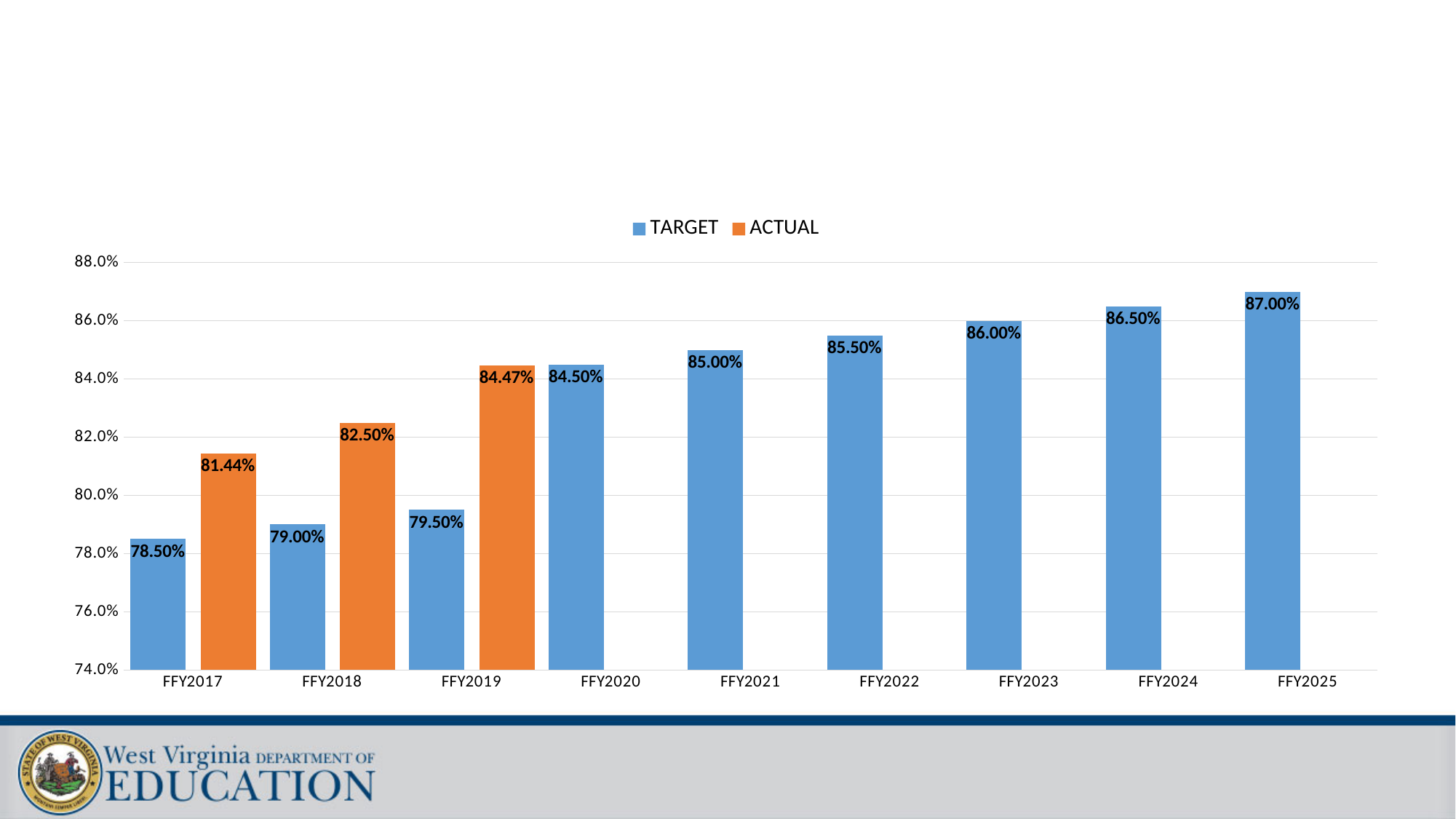
What is the ACTUAL value for FFY2018? 82.50% Do the TARGET values rise or fall from FFY2017 to FFY2025? Rise What is the difference between the ACTUAL and TARGET values for FFY2017? 2.94% What kind of chart is shown on the slide? Bar chart How many series does the legend list? 2 Which year has the lowest TARGET value? FFY2017 Which year has the highest TARGET value? FFY2025 What is the ACTUAL value for FFY2019? 84.47% How many years are shown on the x axis? 9 What is the TARGET value for FFY2025? 87.00% What is the TARGET value for FFY2017? 78.50% Which is larger for FFY2019, the TARGET or the ACTUAL value? ACTUAL